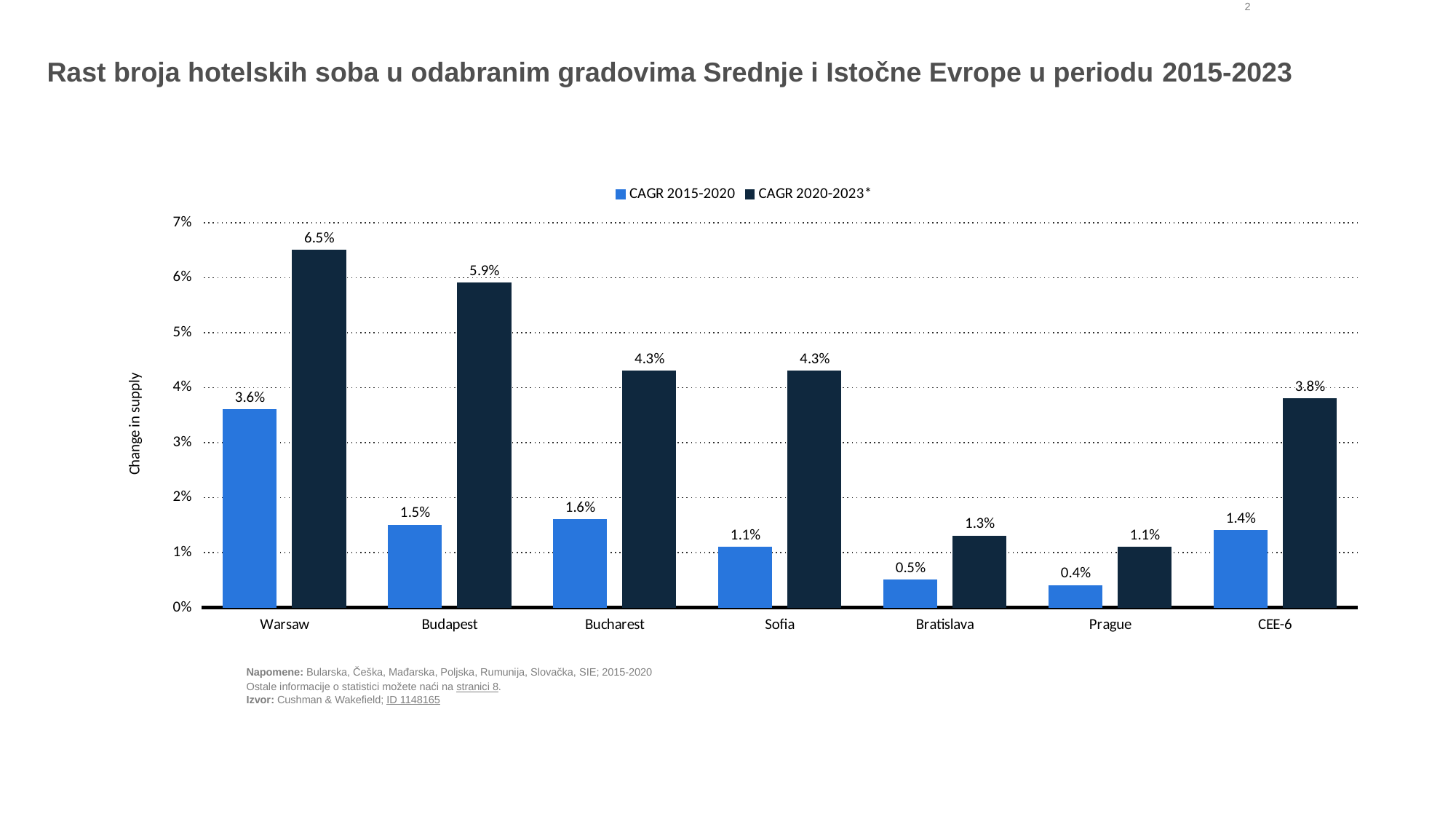
Which category has the lowest CAGR 2015-2020 value? Prague What is the CAGR 2015-2020 value for Warsaw? 3.6% What is the label of the y axis? Change in supply How many series does the legend list? 2 Which city has the highest CAGR 2020-2023* value? Warsaw What is the CAGR 2015-2020 value for Prague? 0.4% What is the CAGR 2020-2023* value for Budapest? 5.9% What kind of chart is shown on the slide? Bar chart How many categories are shown on the x axis? 7 Which is larger: the CAGR 2015-2020 value for Bucharest or for Budapest? Bucharest What is the difference between the CAGR 2020-2023* and CAGR 2015-2020 values for Warsaw? 2.9% Is the CAGR 2020-2023* value for Sofia greater or less than 4%? greater